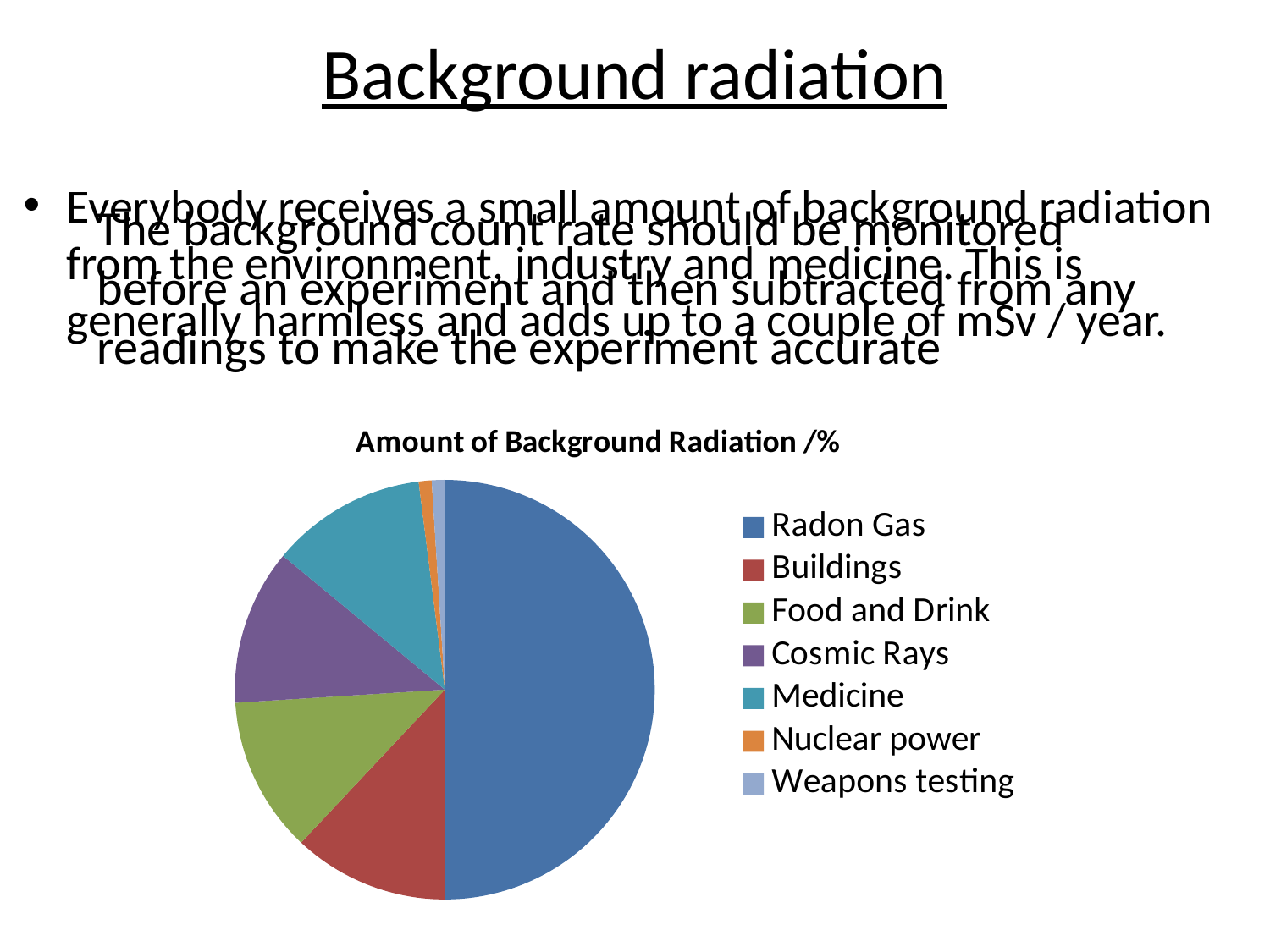
What kind of chart is shown on the slide? pie chart Which is larger in the pie chart, Food and Drink or Nuclear power? Food and Drink Which is larger in the pie chart, Cosmic Rays or Weapons testing? Cosmic Rays Which is larger in the pie chart, Medicine or Nuclear power? Medicine Which category has the largest slice of the pie chart? Radon Gas How many categories does the pie chart's legend list? 7 Which category is listed first in the chart's legend? Radon Gas What colour is the Radon Gas slice in the pie chart? blue What is the title of the chart? Amount of Background Radiation /%